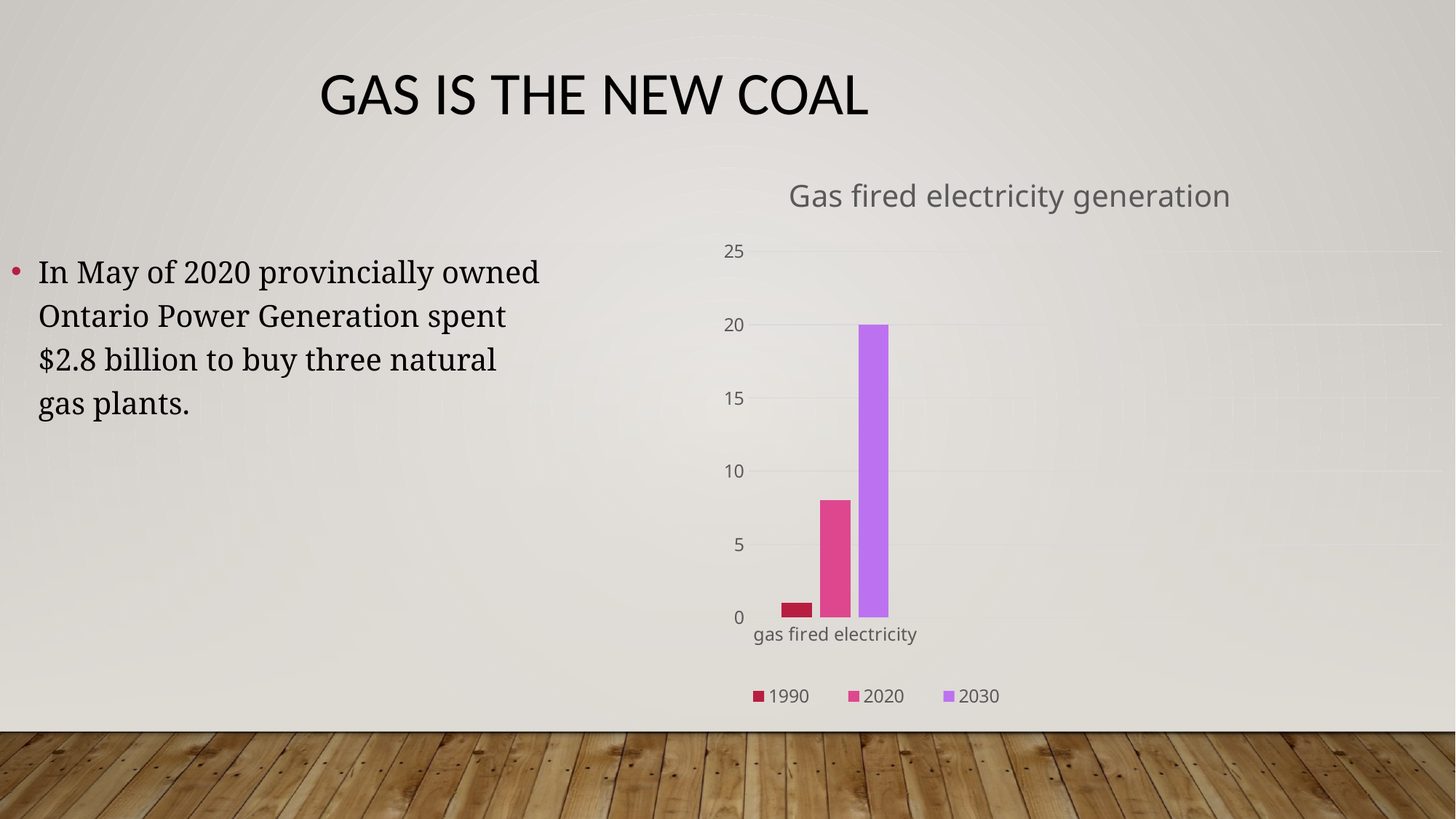
Which series has the lowest value for gas fired electricity? 1990 Which is larger, the value for 2020 or the value for 1990? 2020 What is the value for 2030 in the chart? 20 Which series has the highest value for gas fired electricity? 2030 Is the value for 2020 greater or less than 5? greater Which series are listed in the chart legend? 1990, 2020, 2030 How many series does the chart legend list? 3 What kind of chart is shown on the slide? bar chart What is the title of the chart? Gas fired electricity generation How many categories are shown on the x axis of the chart? 1 Is the value for 1990 greater or less than 5? less Is the value for 2020 greater or less than 10? less